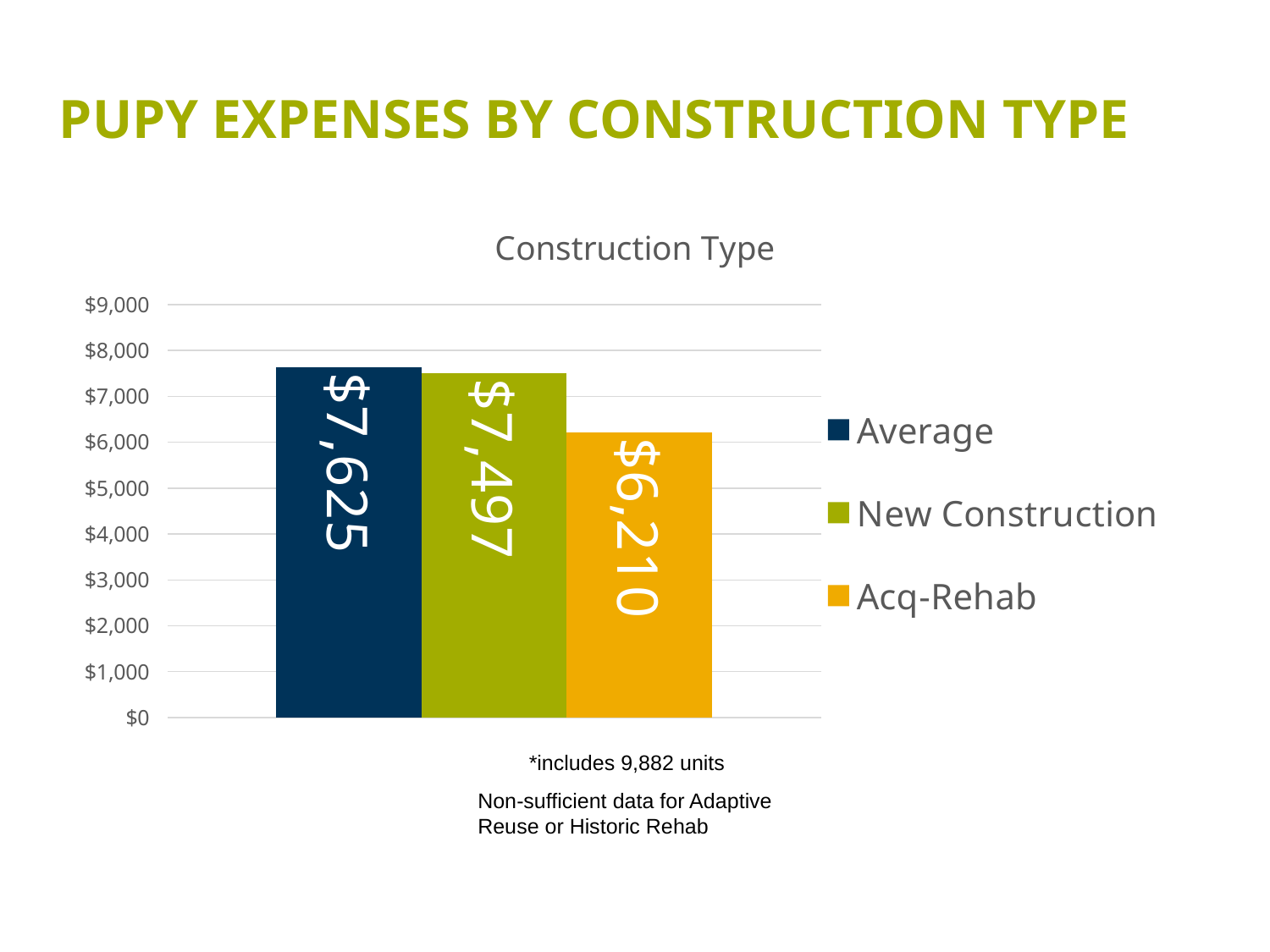
Which series has the lowest value? Acq-Rehab Is the value for Acq-Rehab greater or less than $7,000? less How many series does the legend list? 3 What is the value for Acq-Rehab? $6,210 What kind of chart is shown on the slide? bar chart What is the value for Average? $7,625 What is the difference between the Average value and the Acq-Rehab value? $1,415 What is the title of the chart? Construction Type Which series has the highest value? Average Which is larger, the value for New Construction or the value for Acq-Rehab? New Construction What is the value for New Construction? $7,497 What is the difference between the New Construction value and the Acq-Rehab value? $1,287